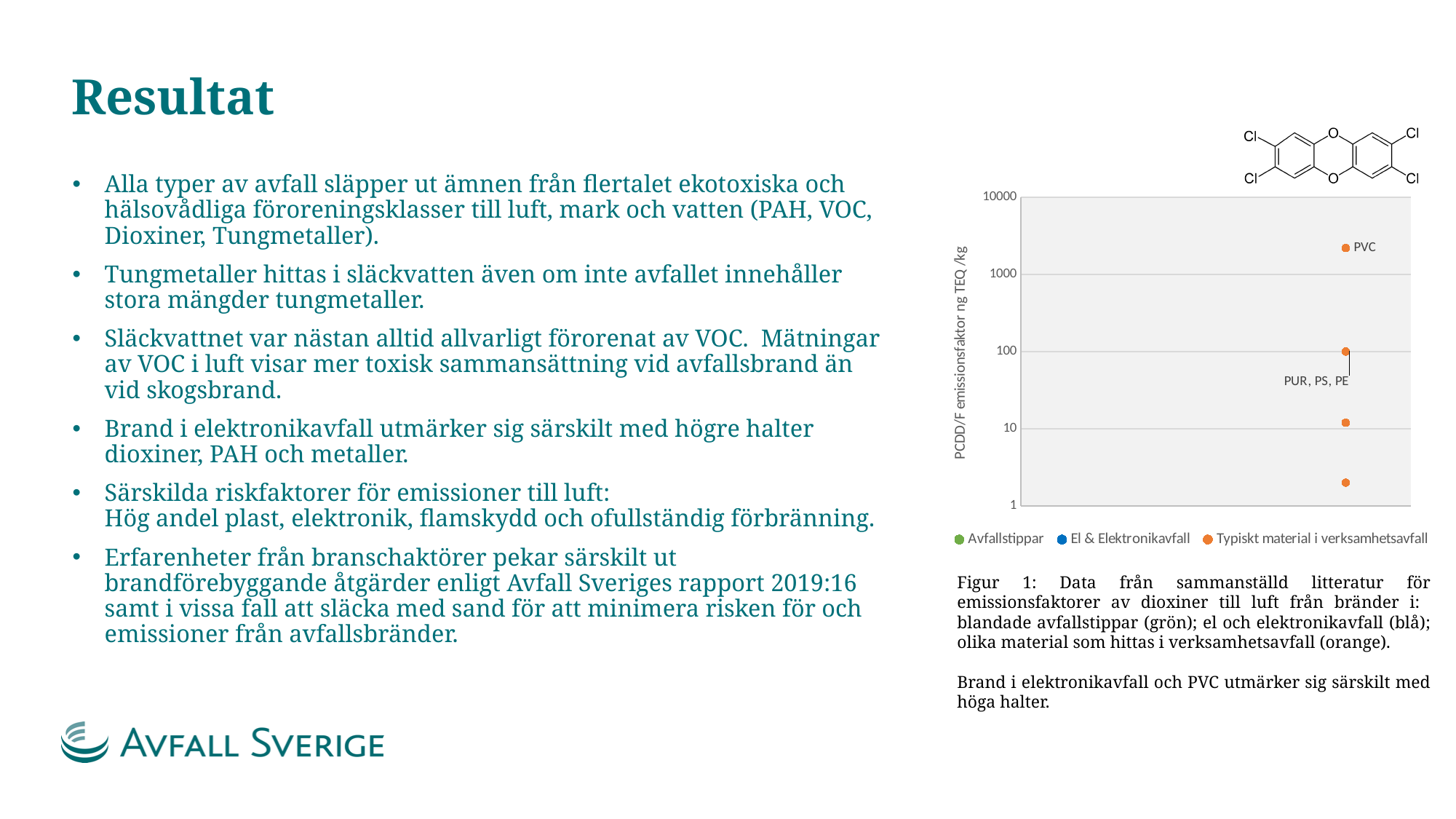
What kind of chart is shown on the slide? scatter chart Which colour represents the series 'Typiskt material i verksamhetsavfall' in the chart legend? orange Is the lowest plotted point in the chart greater or less than 10? less How many series does the chart legend list? 3 What is the label of the y-axis in the chart? PCDD/F emissionsfaktor ng TEQ /kg Which has a higher emission factor in the chart, PVC or PUR, PS, PE? PVC Is the value for PVC greater or less than 10000? less Which labelled material has the highest PCDD/F emission factor in the chart? PVC Is the value for PVC greater or less than 1000? greater